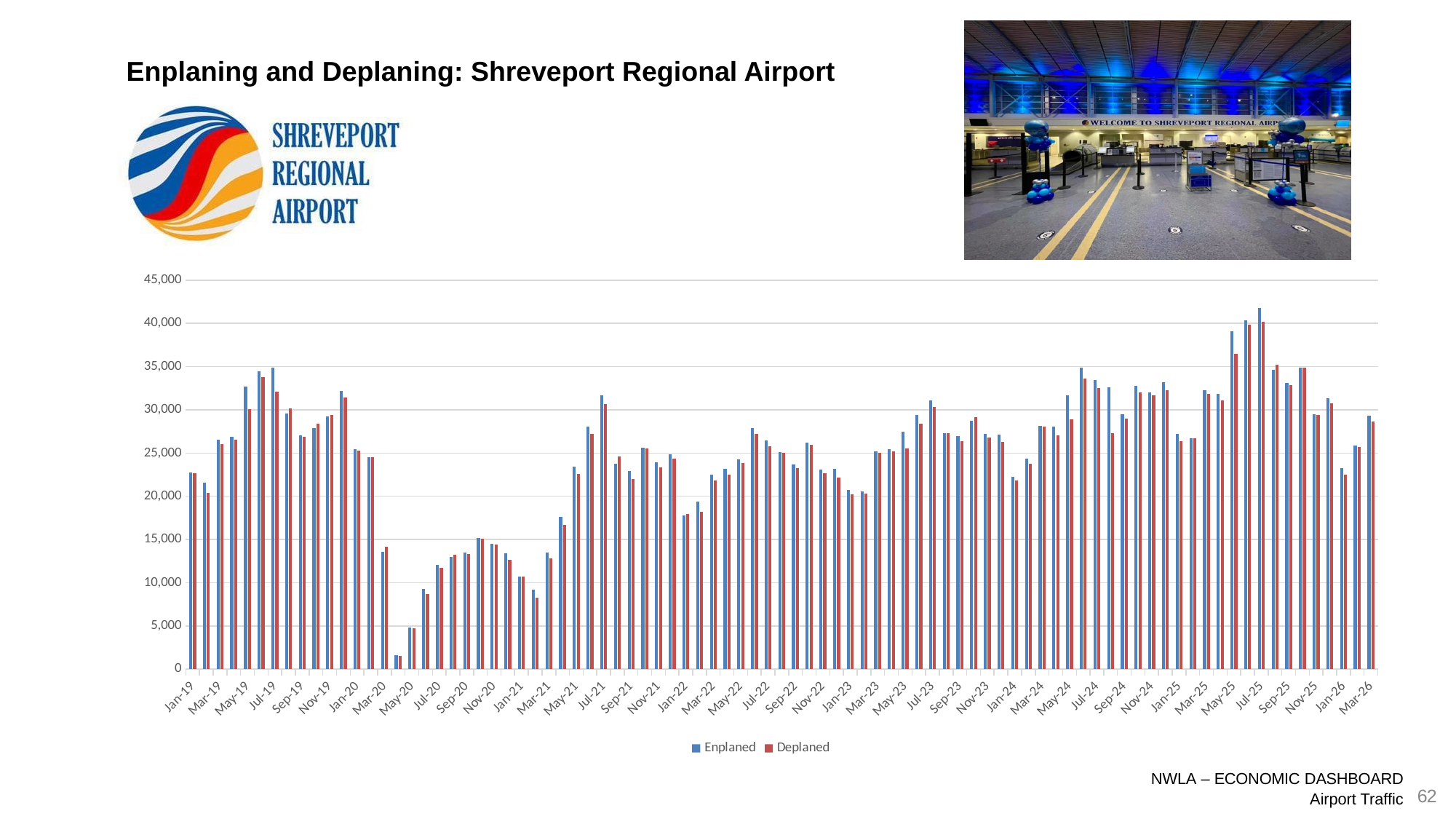
Which month has the highest Enplaned value? Jul-25 Is the Enplaned value for Mar-20 greater or less than 15,000? less Is the Deplaned value for Jul-19 greater or less than 30,000? greater Which colour represents the Deplaned series in the legend? Red What kind of chart is shown on the slide? Bar chart Is the Enplaned value for Jul-25 greater or less than 40,000? greater Which is larger, the Enplaned value for Jul-25 or the Enplaned value for Jul-19? Jul-25 Do the Enplaned values rise or fall from Jan-20 to May-20? fall Which month has the lowest Enplaned value? Apr-20 How many series does the legend list? 2